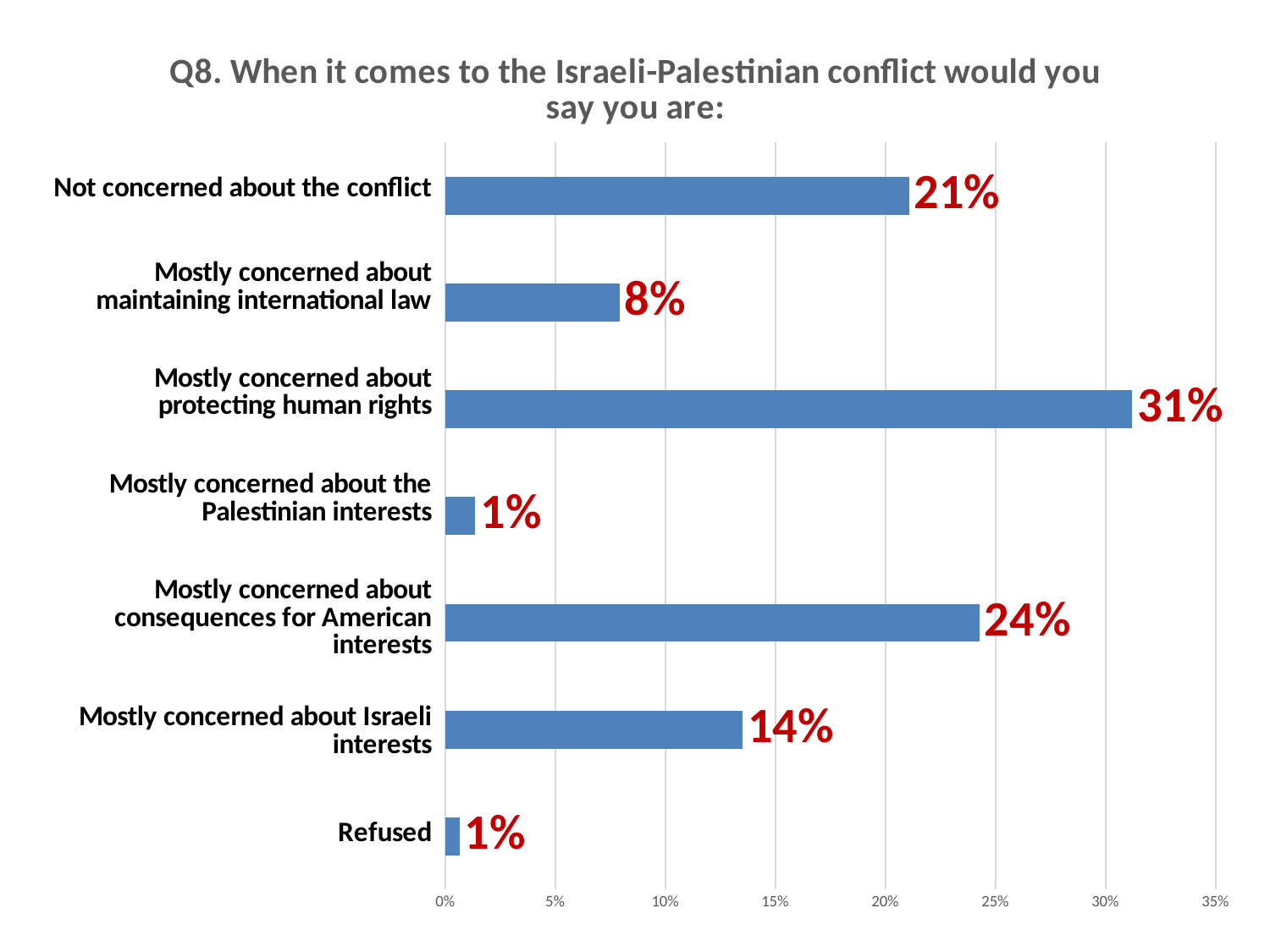
What is the value for 'Mostly concerned about protecting human rights'? 31% What kind of chart is shown on the slide? Bar chart What is the value for 'Mostly concerned about Israeli interests'? 14% Is the value for 'Mostly concerned about consequences for American interests' greater or less than 20%? greater What is the title of the chart? Q8. When it comes to the Israeli-Palestinian conflict would you say you are: What is the difference between 'Not concerned about the conflict' and 'Mostly concerned about maintaining international law'? 13% How many categories are shown in the chart? 7 What is the difference between 'Mostly concerned about protecting human rights' and 'Mostly concerned about consequences for American interests'? 7% What percentage are mostly concerned about consequences for American interests? 24% What percentage of respondents said they are not concerned about the conflict? 21% Which is larger: 'Not concerned about the conflict' or 'Mostly concerned about Israeli interests'? Not concerned about the conflict Which category has the highest value? Mostly concerned about protecting human rights